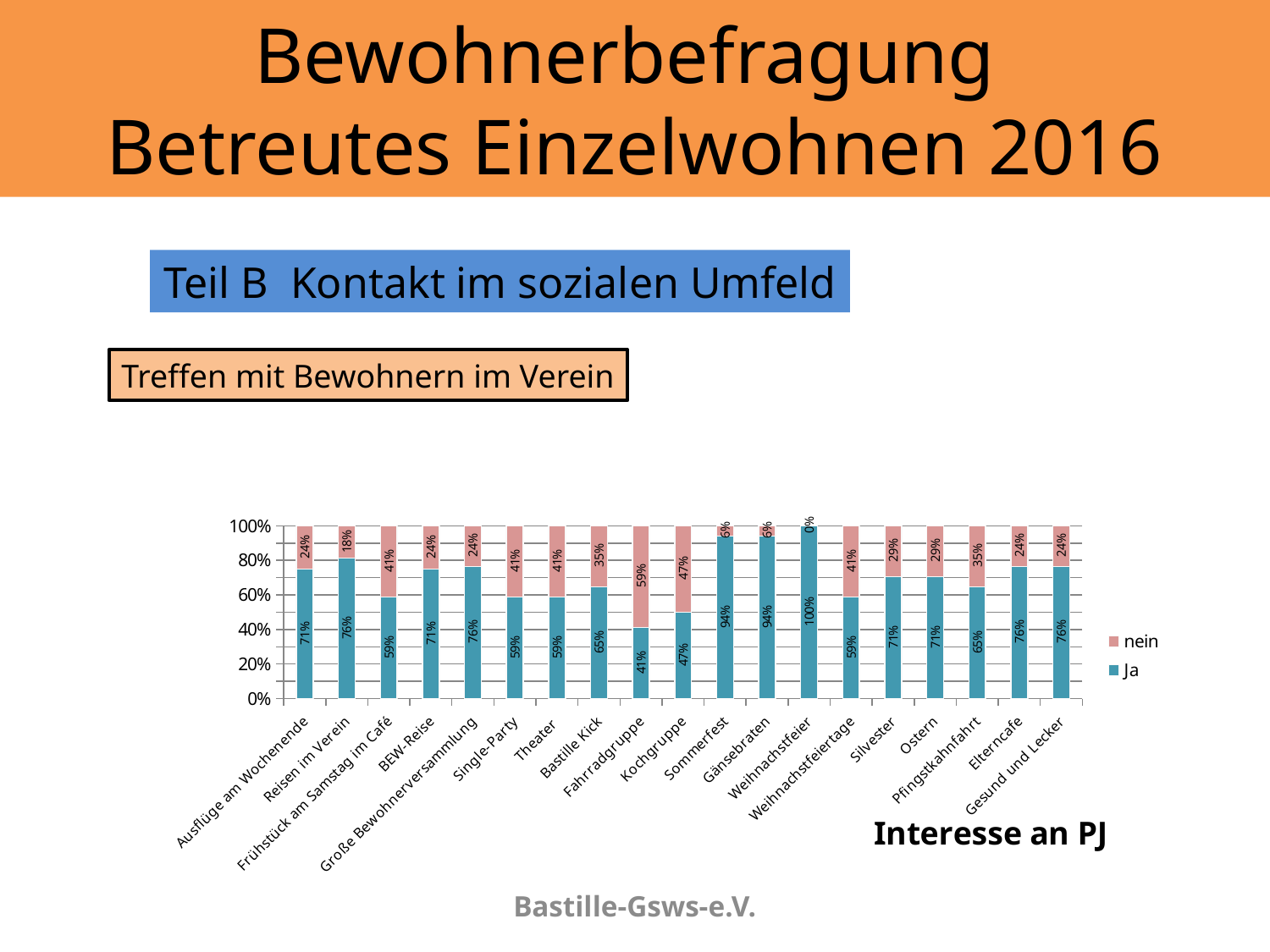
How many series does the legend list? 2 What is the difference between the "Ja" values for Gänsebraten and Kochgruppe? 47% What is the "Ja" value for Sommerfest? 94% How many categories are shown on the x axis? 19 What kind of chart is shown on the slide? Stacked bar chart What is the "nein" value for Reisen im Verein? 18% Which category has the highest "Ja" share? Weihnachtsfeier What percentage of respondents answered "Ja" for Weihnachtsfeier? 100% What is the "nein" value for Fahrradgruppe? 59% What are the two legend entries of the chart? nein and Ja Which category has the lowest "Ja" share? Fahrradgruppe Which has a larger "Ja" value, Bastille Kick or Elterncafe? Elterncafe